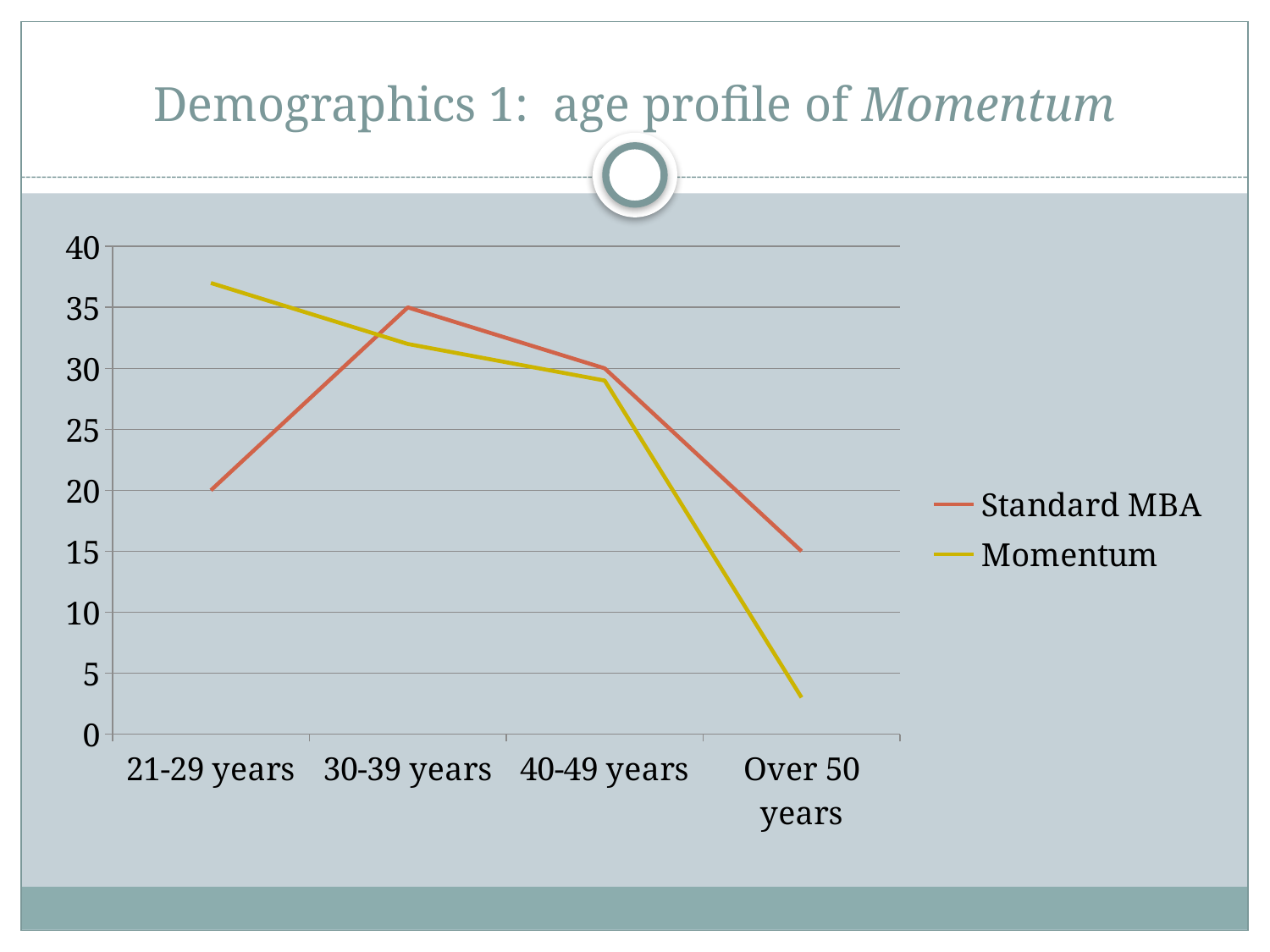
Is the value for Momentum in the Over 50 years category greater or less than 5? less Which age category has the lowest value for Momentum? Over 50 years What kind of chart is shown on the slide? line chart What is the value for Standard MBA in the 30-39 years category? 35 How many series does the legend list? 2 Which age category has the highest value for Standard MBA? 30-39 years Does the Momentum line rise or fall from 21-29 years to Over 50 years? fall What is the value for Standard MBA in the 21-29 years category? 20 Is the value for Momentum in the 21-29 years category greater or less than 35? greater What is the value for Standard MBA in the Over 50 years category? 15 In the 21-29 years category, which series has the larger value, Standard MBA or Momentum? Momentum How many age categories are shown on the x axis? 4